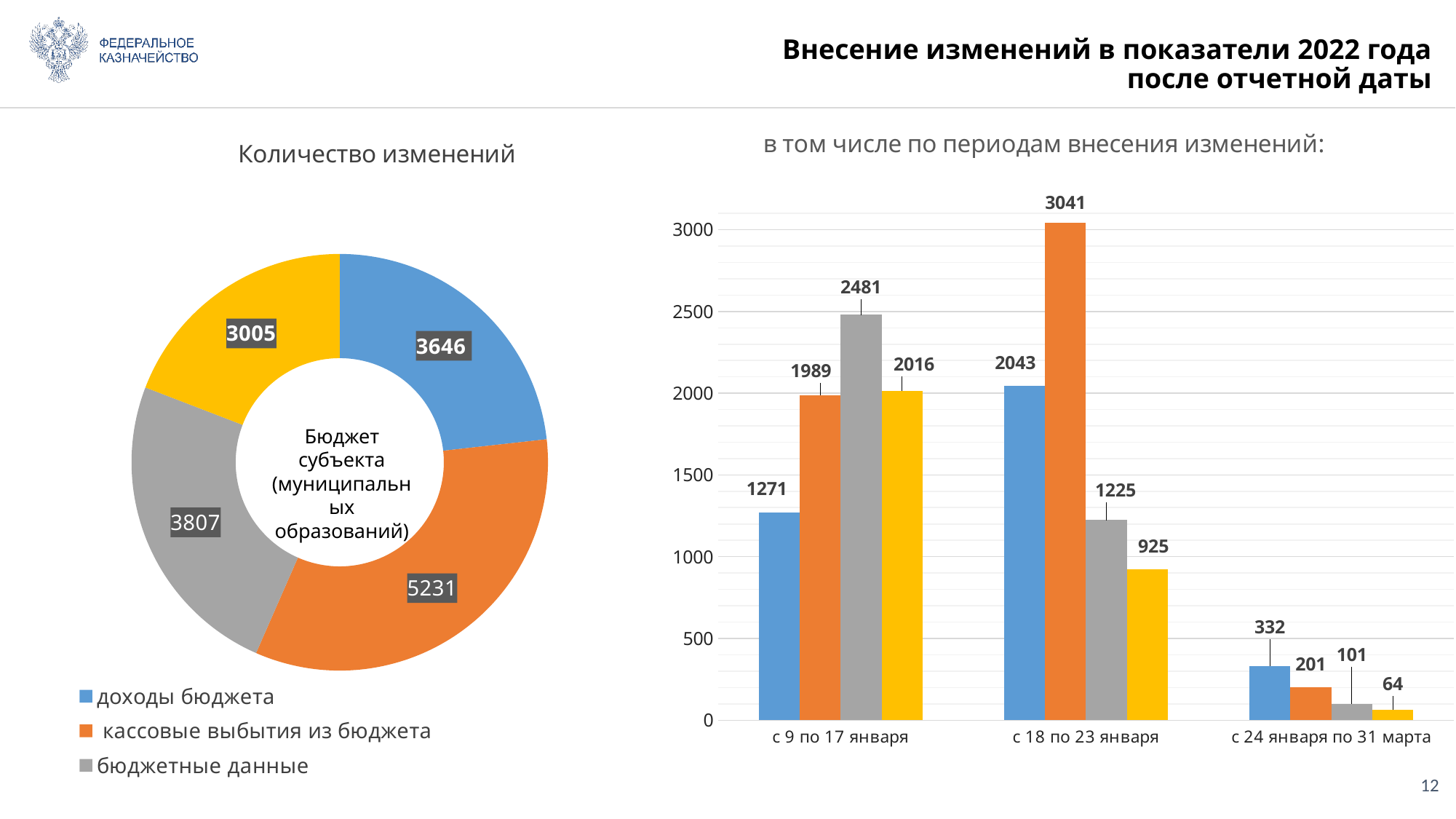
In the doughnut chart "Количество изменений", which legend category has the largest value? кассовые выбытия из бюджета What kind of chart is the chart titled "Количество изменений"? Doughnut (pie) chart In the doughnut chart "Количество изменений", what is the value for кассовые выбытия из бюджета? 5231 In the bar chart "в том числе по периодам внесения изменений", what is the difference between кассовые выбытия из бюджета and доходы бюджета in the period с 18 по 23 января? 998 In the bar chart "в том числе по периодам внесения изменений", what is the value for доходы бюджета in the period с 18 по 23 января? 2043 In the bar chart "в том числе по периодам внесения изменений", which is larger in the period с 24 января по 31 марта: доходы бюджета or бюджетные данные? доходы бюджета What kind of chart is the chart titled "в том числе по периодам внесения изменений"? Bar chart In the doughnut chart "Количество изменений", what is the difference between the values for кассовые выбытия из бюджета and доходы бюджета? 1585 In the bar chart "в том числе по периодам внесения изменений", how many periods are shown on the x axis? 3 How many entries does the legend of the chart "Количество изменений" list? 3 In the bar chart "в том числе по периодам внесения изменений", what is the highest value shown on any bar? 3041 In the bar chart "в том числе по периодам внесения изменений", what is the value for бюджетные данные in the period с 9 по 17 января? 2481